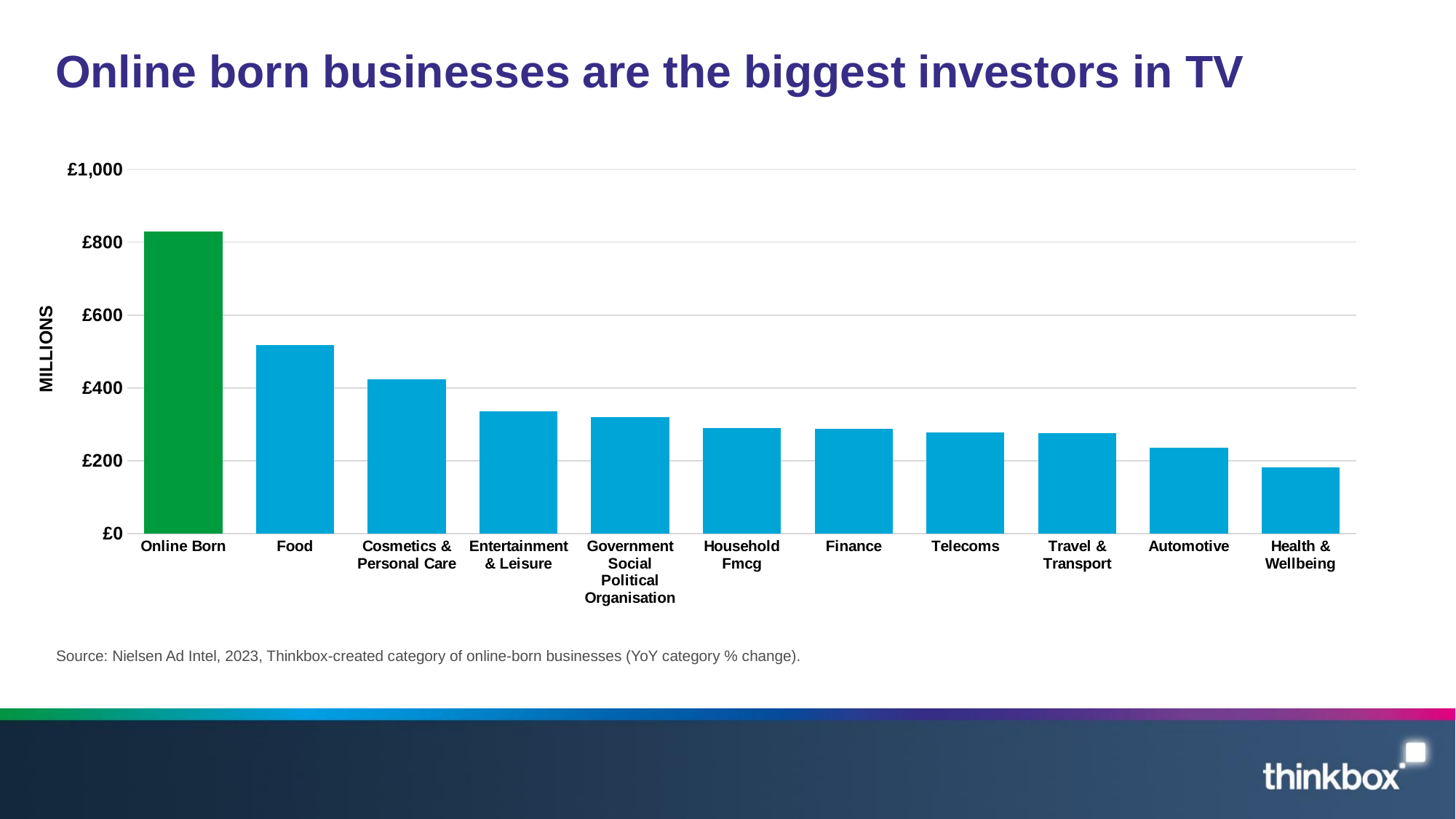
Is the value for Cosmetics & Personal Care greater or less than £400? greater Which category has the highest value in the chart? Online Born How many categories are shown on the x axis of the chart? 11 Which bar in the chart is coloured green rather than blue? Online Born Is the value for Online Born greater or less than £800? greater Is the value for Entertainment & Leisure greater or less than £400? less Do the values rise or fall moving from left to right along the x axis? Fall Which is larger, the value for Food or the value for Cosmetics & Personal Care? Food What kind of chart is shown on the slide? Bar chart Which category has the lowest value in the chart? Health & Wellbeing